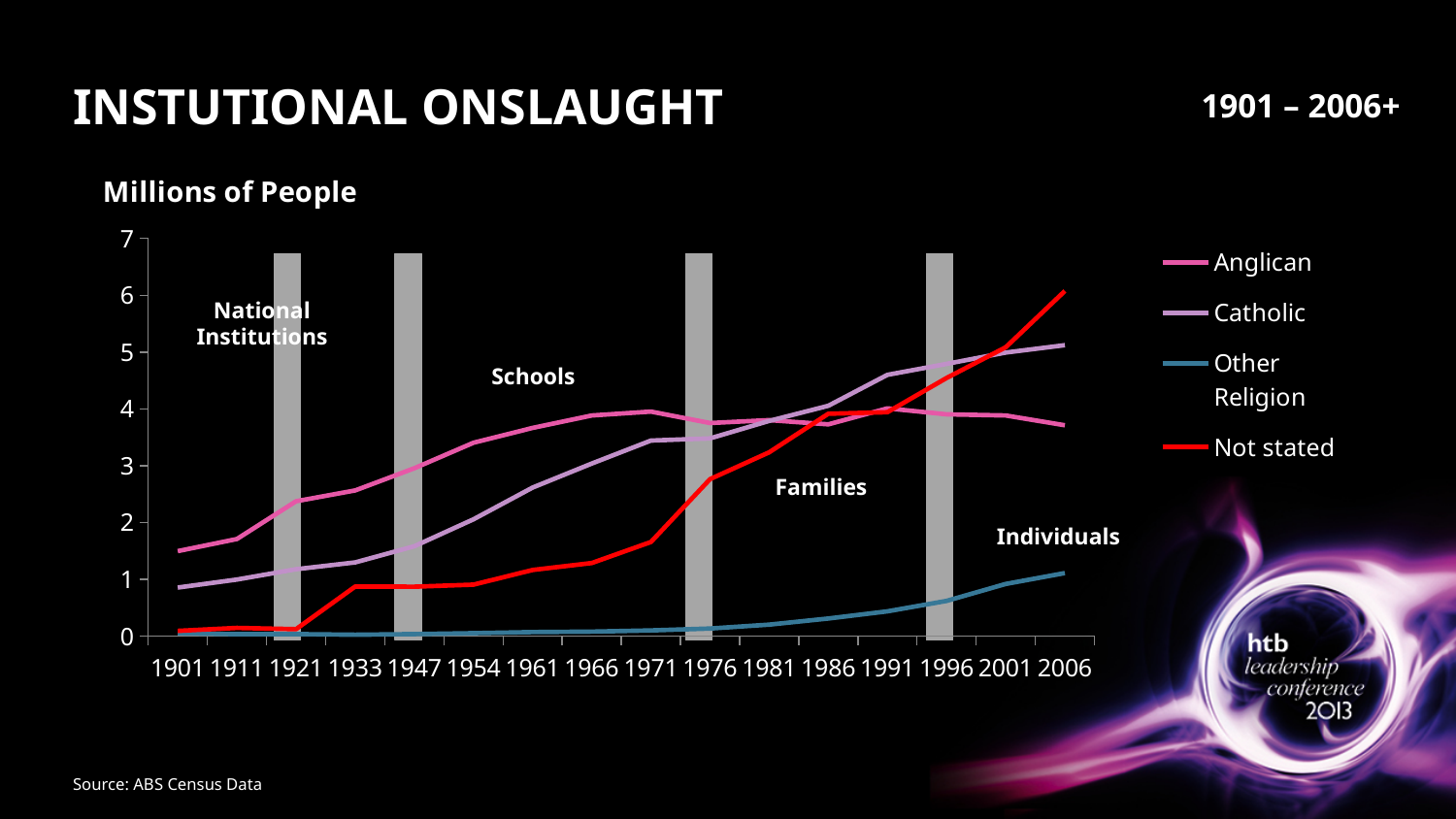
Which series has the highest value in 2006? Not stated In 2006, which is larger: Not stated or Anglican? Not stated Is the value for Not stated in 2006 greater or less than 5? greater Is the value for Other Religion in 2006 greater or less than 2? less What kind of chart is shown on the slide? line chart In 1901, which is larger: Anglican or Catholic? Anglican How many series does the legend list? 4 Is the value for Anglican in 1901 greater or less than 2? less Does the Anglican line rise or fall between 1971 and 2006? fall How many census years are marked along the x axis? 16 Which series has the lowest value in 2006? Other Religion